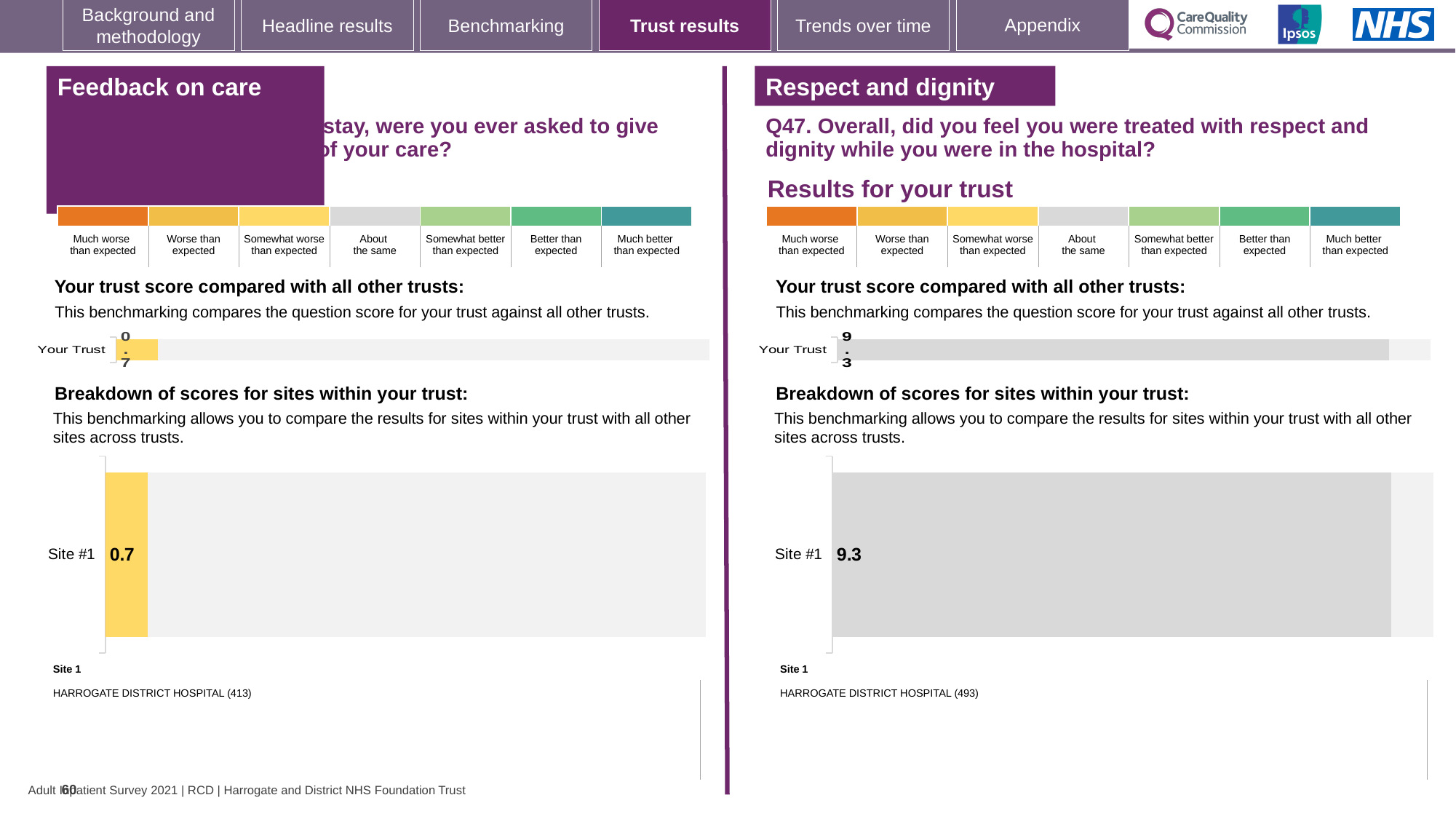
Which site is listed as Site 1 below the charts on the 'Respect and dignity' side of the slide? HARROGATE DISTRICT HOSPITAL (493) What is the difference between the Site #1 score on the 'Respect and dignity' side and the Site #1 score on the 'Feedback on care' side? 8.6 What type of chart is used to show the Site #1 score on the 'Respect and dignity' side of the slide? Bar chart On the 'Respect and dignity' side of the slide, what is the score shown for Site #1 in the 'Breakdown of scores for sites within your trust' chart? 9.3 How many sites are shown in the 'Breakdown of scores for sites within your trust' chart on the 'Respect and dignity' side? 1 What colour is the Site #1 bar in the 'Breakdown of scores for sites within your trust' chart on the 'Feedback on care' side? Yellow On the 'Respect and dignity' side of the slide, what is the score shown for Your Trust in the 'Your trust score compared with all other trusts' chart? 9.3 On the 'Feedback on care' side of the slide, what is the score shown for Site #1 in the 'Breakdown of scores for sites within your trust' chart? 0.7 On the 'Respect and dignity' side, is the Site #1 score greater or less than 5? greater How many sites are shown in the 'Breakdown of scores for sites within your trust' chart on the 'Feedback on care' side? 1 Which is larger: the Site #1 score on the 'Respect and dignity' side or the Site #1 score on the 'Feedback on care' side? Respect and dignity On the 'Feedback on care' side of the slide, what is the score shown for Your Trust in the 'Your trust score compared with all other trusts' chart? 0.7